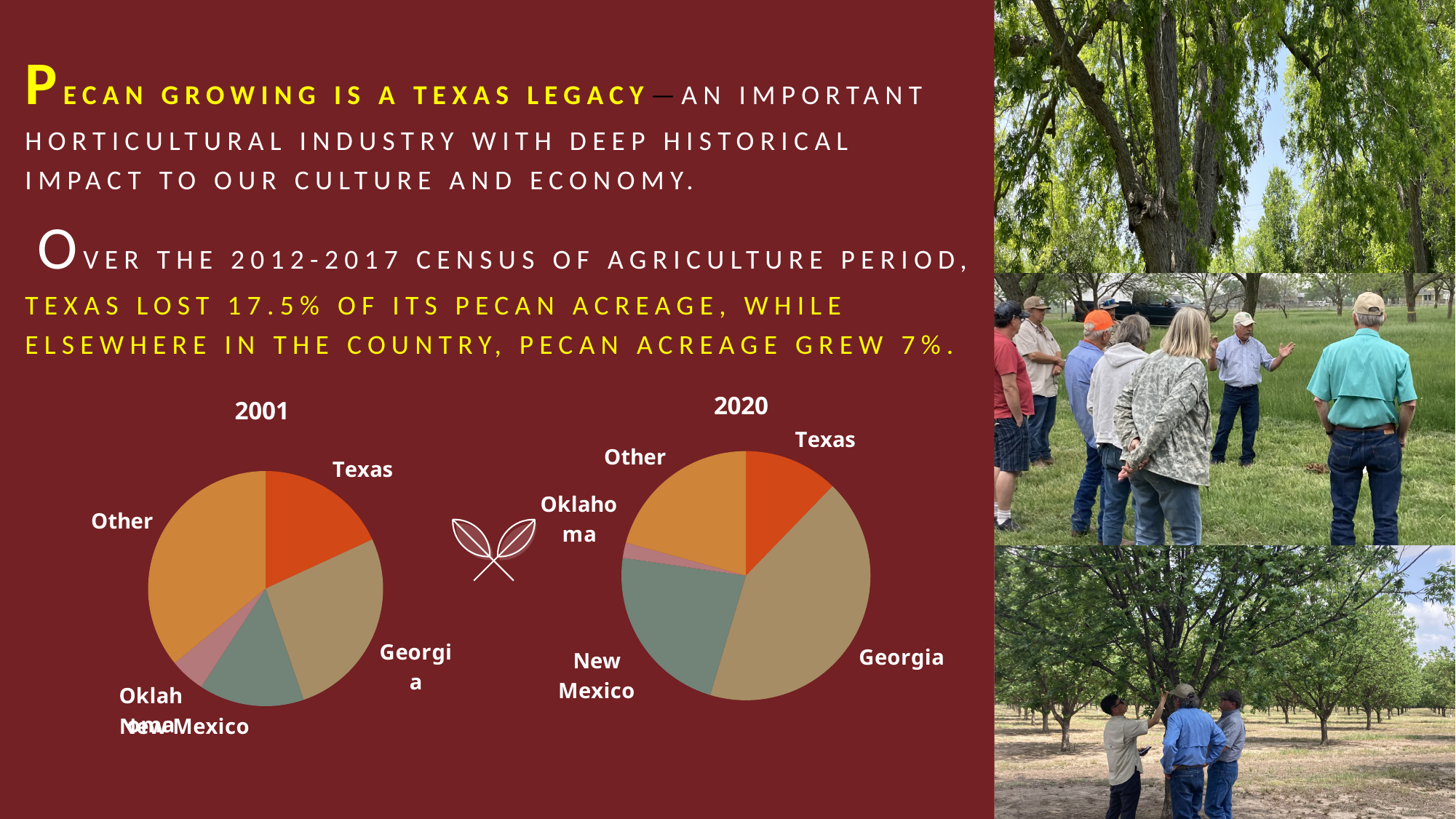
In the 2020 pie chart, which category has the smallest slice? Oklahoma In the 2020 pie chart, which slice is larger, Texas or Other? Other In the 2020 pie chart, which slice is larger, Georgia or Texas? Georgia In the 2001 pie chart, which category has the largest slice? Other What kind of chart is the chart titled 2001? pie chart In the 2020 pie chart, how many slices are there? 5 In the 2020 pie chart, which category has the largest slice? Georgia What kind of chart is the chart titled 2020? pie chart In the 2001 pie chart, which slice is larger, Texas or Oklahoma? Texas In the 2001 pie chart, which category has the smallest slice? Oklahoma In the 2001 pie chart, how many slices are there? 5 What are the titles of the two pie charts on the slide? 2001 and 2020